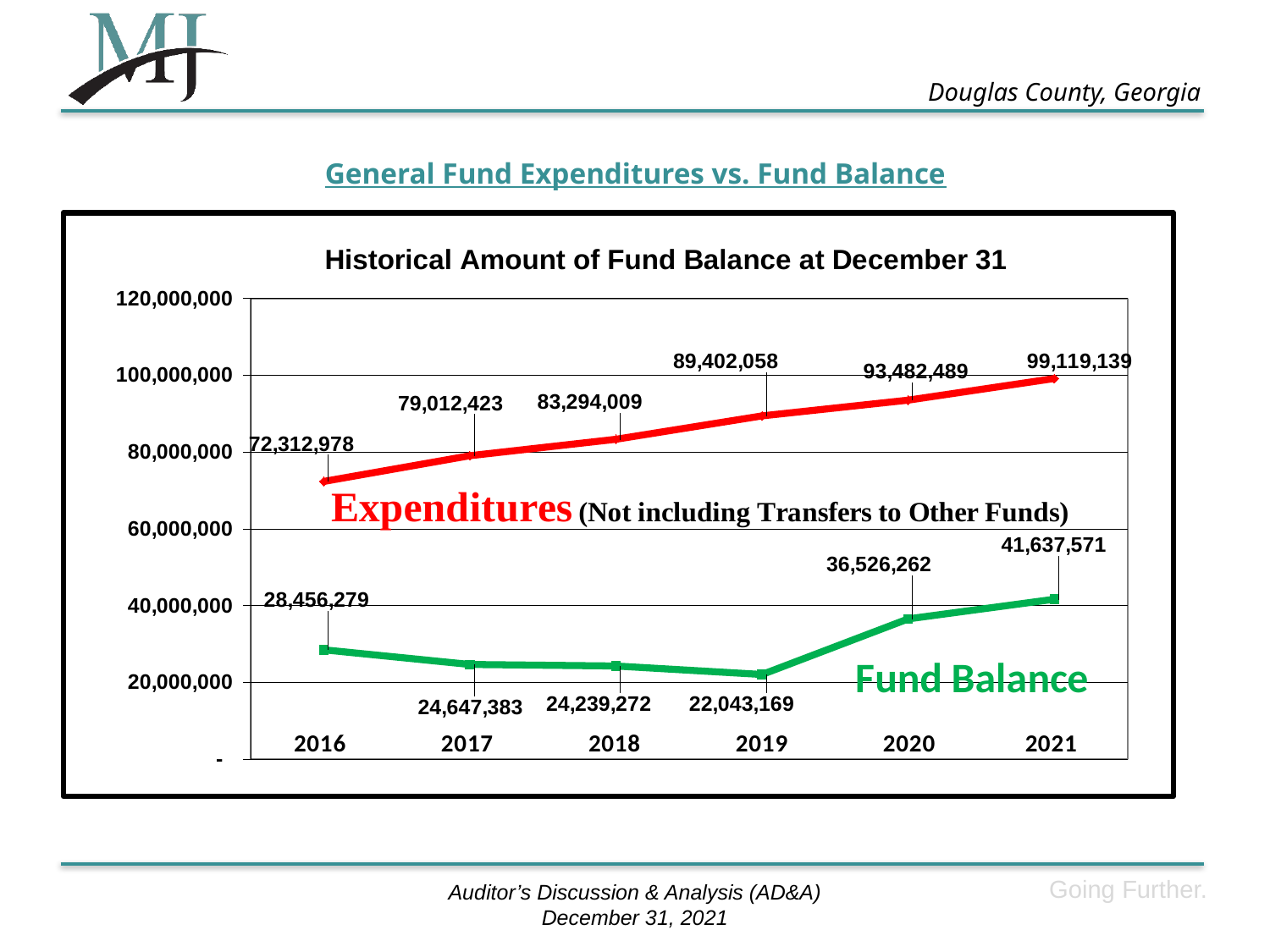
What is the difference between Expenditures and Fund Balance in 2021? 57,481,568 Which is larger, the Fund Balance in 2016 or the Fund Balance in 2018? 2016 By how much did the Fund Balance increase from 2020 to 2021? 5,111,309 In which year is the Fund Balance lowest? 2019 Do Expenditures rise or fall from 2016 to 2021? Rise What is the Fund Balance value for 2020? 36,526,262 What is the Expenditures value for 2016? 72,312,978 In which year are Expenditures highest? 2021 What is the Expenditures value for 2019? 89,402,058 Is the Expenditures value for 2020 greater or less than 80,000,000? greater How many years are shown on the x axis? 6 What kind of chart is shown on the slide? Line chart